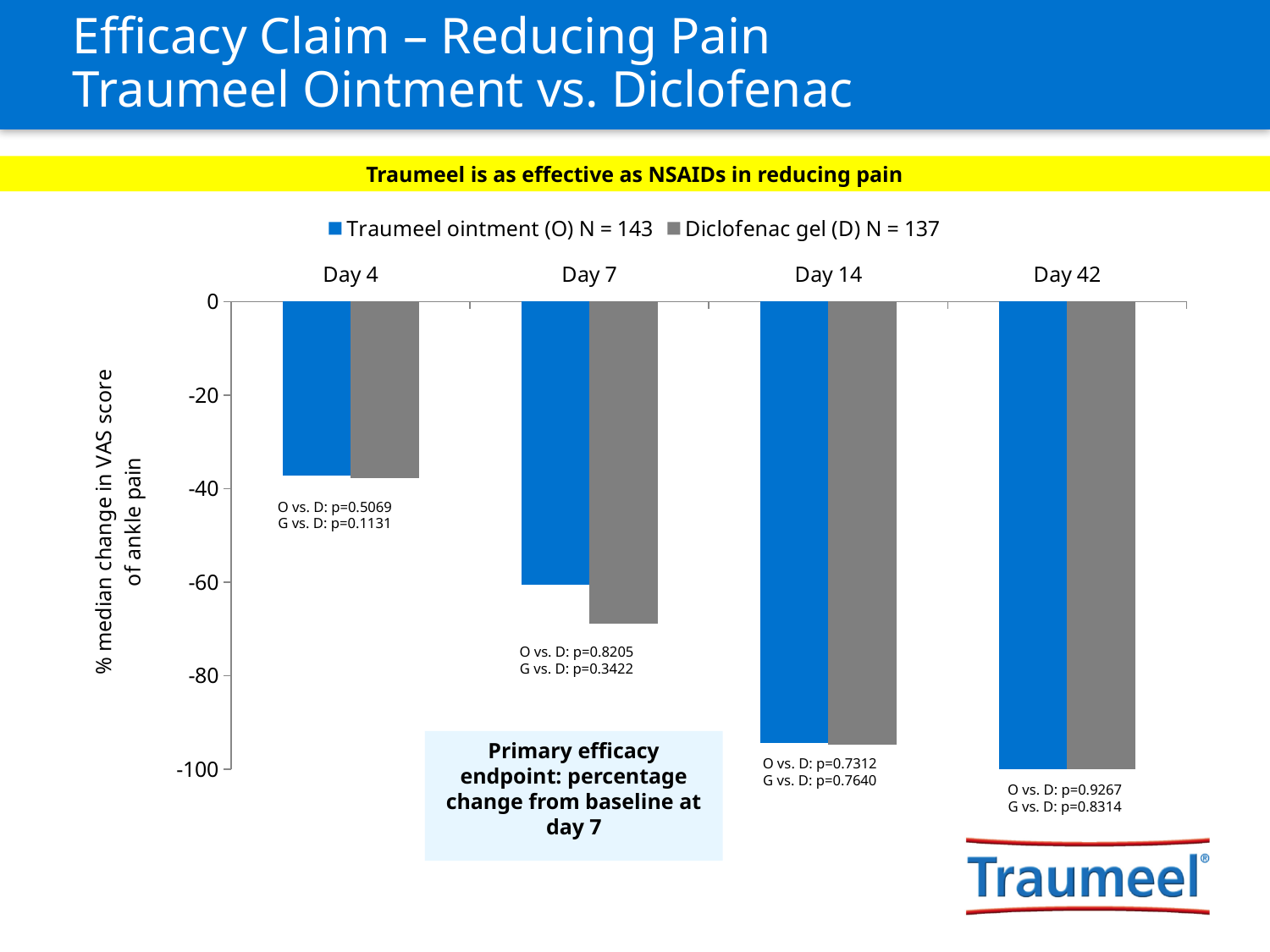
Is the value for Traumeel ointment at Day 14 greater or less than -80? less Do the values for Traumeel ointment rise or fall from Day 4 to Day 42? fall What kind of chart is shown on the slide? bar chart What is the label on the y axis of the chart? % median change in VAS score of ankle pain Is the value for Traumeel ointment at Day 7 greater or less than -80? greater Is the value for Traumeel ointment at Day 4 greater or less than -20? less At Day 7, which series shows the larger decrease in VAS score? Diclofenac gel (D) How many time points (categories) are shown on the x axis of the chart? 4 How many series does the chart legend list? 2 What are the two series named in the chart legend? Traumeel ointment (O) N = 143 and Diclofenac gel (D) N = 137 At which time point is the Traumeel ointment value the highest (least negative)? Day 4